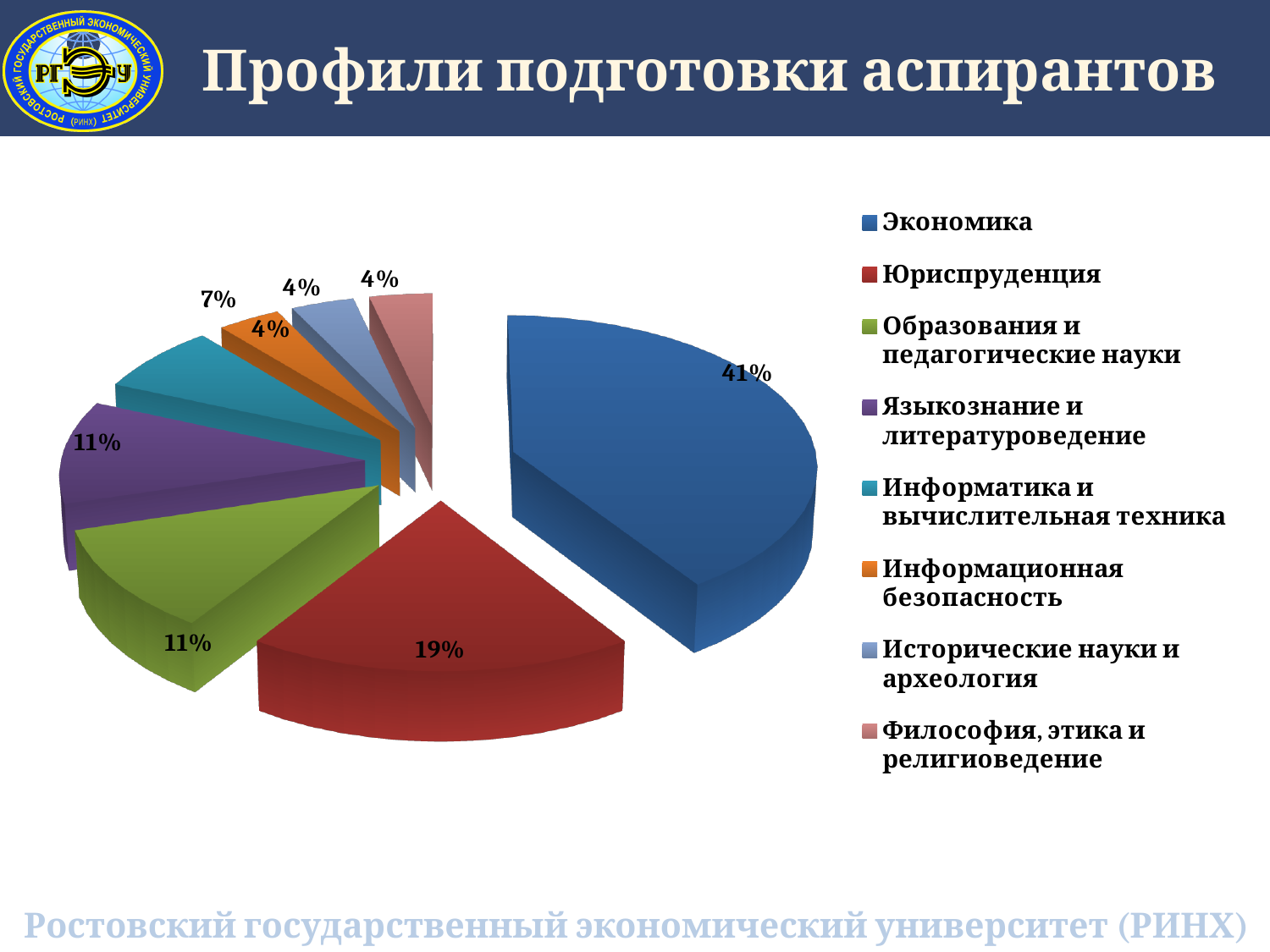
Which is larger, the share of Юриспруденция or the share of Образования и педагогические науки? Юриспруденция How many categories does the legend list? 8 What share of the pie does Юриспруденция have? 19% What is the difference between the shares of Информатика и вычислительная техника and Исторические науки и археология? 3% What share of the pie does Информатика и вычислительная техника have? 7% What is the difference between the shares of Экономика and Юриспруденция? 22% What share of the pie does Экономика have? 41% What is the title of the slide containing the chart? Профили подготовки аспирантов What kind of chart is shown on the slide? pie chart Which category has the largest slice of the pie? Экономика What share of the pie does Языкознание и литературоведение have? 11% What share of the pie does Информационная безопасность have? 4%